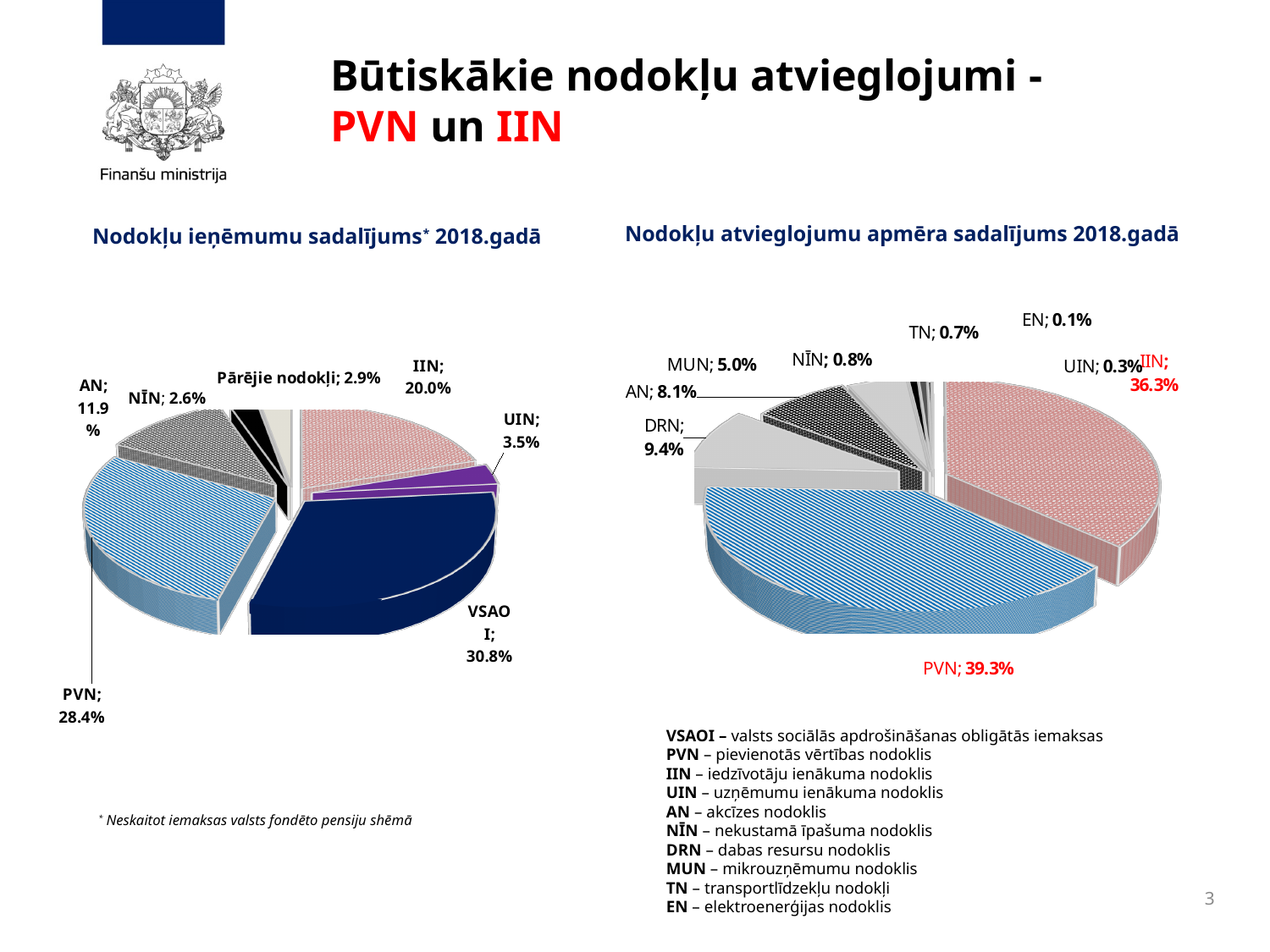
In the right chart (Nodokļu atvieglojumu apmēra sadalījums 2018.gadā), what share does DRN have? 9.4% In the left chart (Nodokļu ieņēmumu sadalījums 2018.gadā), how many slices does the pie have? 7 What type of chart is used on this slide? Pie chart In the right chart (Nodokļu atvieglojumu apmēra sadalījums 2018.gadā), what share does IIN have? 36.3% In the left chart (Nodokļu ieņēmumu sadalījums 2018.gadā), what is the difference between the IIN share and the AN share? 8.1 percentage points In the left chart (Nodokļu ieņēmumu sadalījums 2018.gadā), which category has the largest share? VSAOI In the left chart (Nodokļu ieņēmumu sadalījums 2018.gadā), what share does VSAOI have? 30.8% In the left chart (Nodokļu ieņēmumu sadalījums 2018.gadā), which category has the smallest share? NĪN In the left chart (Nodokļu ieņēmumu sadalījums 2018.gadā), what share does PVN have? 28.4% In the right chart (Nodokļu atvieglojumu apmēra sadalījums 2018.gadā), which is larger, the share for MUN or the share for AN? AN In the right chart (Nodokļu atvieglojumu apmēra sadalījums 2018.gadā), which category has the largest share? PVN In the right chart (Nodokļu atvieglojumu apmēra sadalījums 2018.gadā), which category has the smallest share? EN